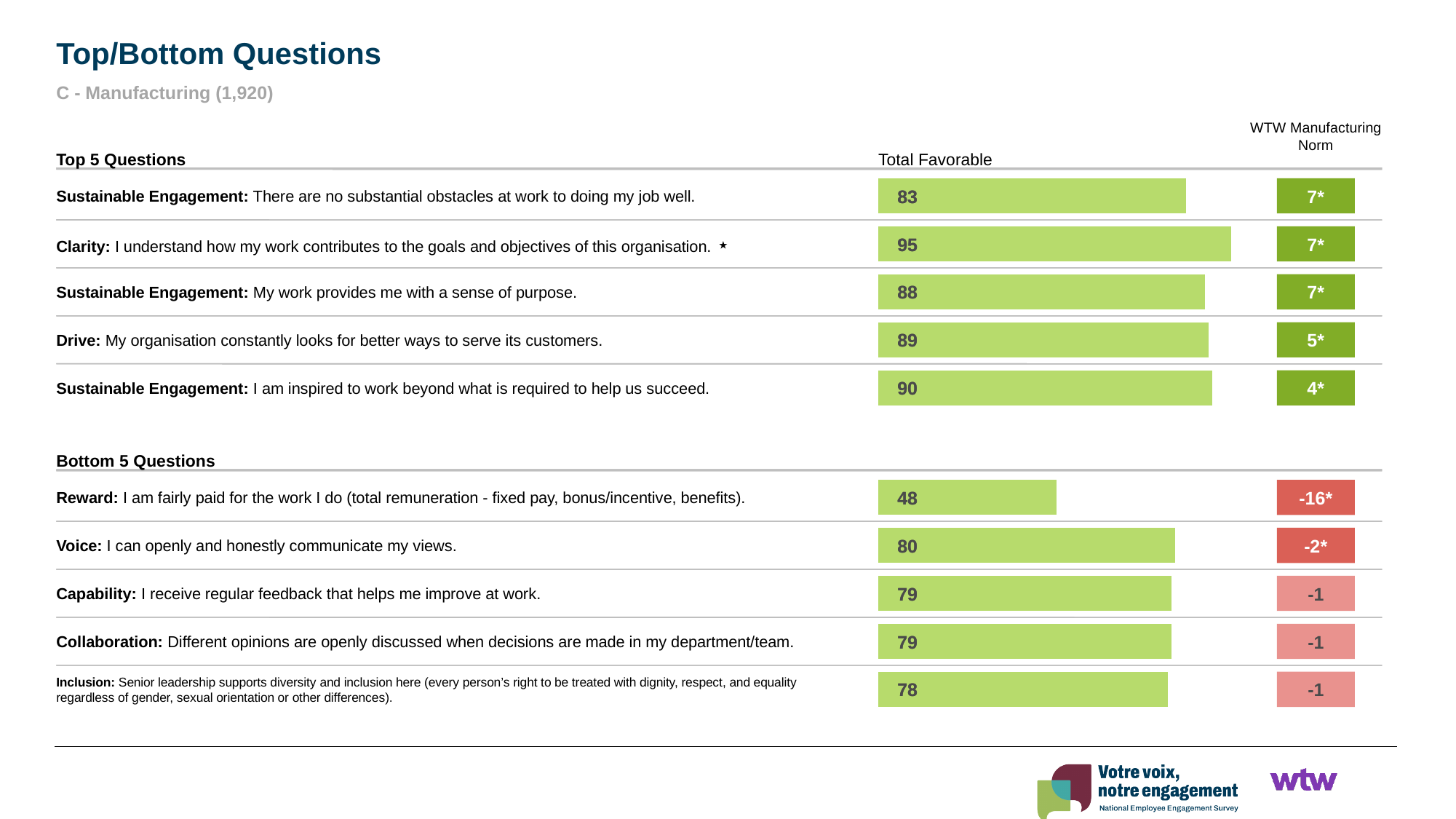
What is the subtitle shown under the slide title "Top/Bottom Questions"? C - Manufacturing (1,920) In the Bottom 5 Questions chart, what is the WTW Manufacturing Norm difference shown for the Reward question? -16* In the Top 5 Questions chart, which question has the highest Total Favorable value? Clarity: I understand how my work contributes to the goals and objectives of this organisation. In the Bottom 5 Questions chart, what is the Total Favorable value for the Reward question "I am fairly paid for the work I do"? 48 In the Bottom 5 Questions chart, which question has the lowest Total Favorable value? Reward: I am fairly paid for the work I do (total remuneration - fixed pay, bonus/incentive, benefits). In the Top 5 Questions chart, what is the WTW Manufacturing Norm difference shown for the Drive question "My organisation constantly looks for better ways to serve its customers"? 5* What kind of chart is used to show the Total Favorable values on this slide? Bar chart In the Top 5 Questions chart, what is the Total Favorable value for the Clarity question "I understand how my work contributes to the goals and objectives of this organisation"? 95 In the Bottom 5 Questions chart, which has a higher Total Favorable value: the Voice question or the Inclusion question? Voice In the Top 5 Questions chart, what is the difference in Total Favorable between the Clarity question (95) and the Sustainable Engagement question "There are no substantial obstacles at work to doing my job well" (83)? 12 In the Top 5 Questions chart, what is the Total Favorable value for the Sustainable Engagement question "I am inspired to work beyond what is required to help us succeed"? 90 How many questions are shown in the Bottom 5 Questions chart? 5